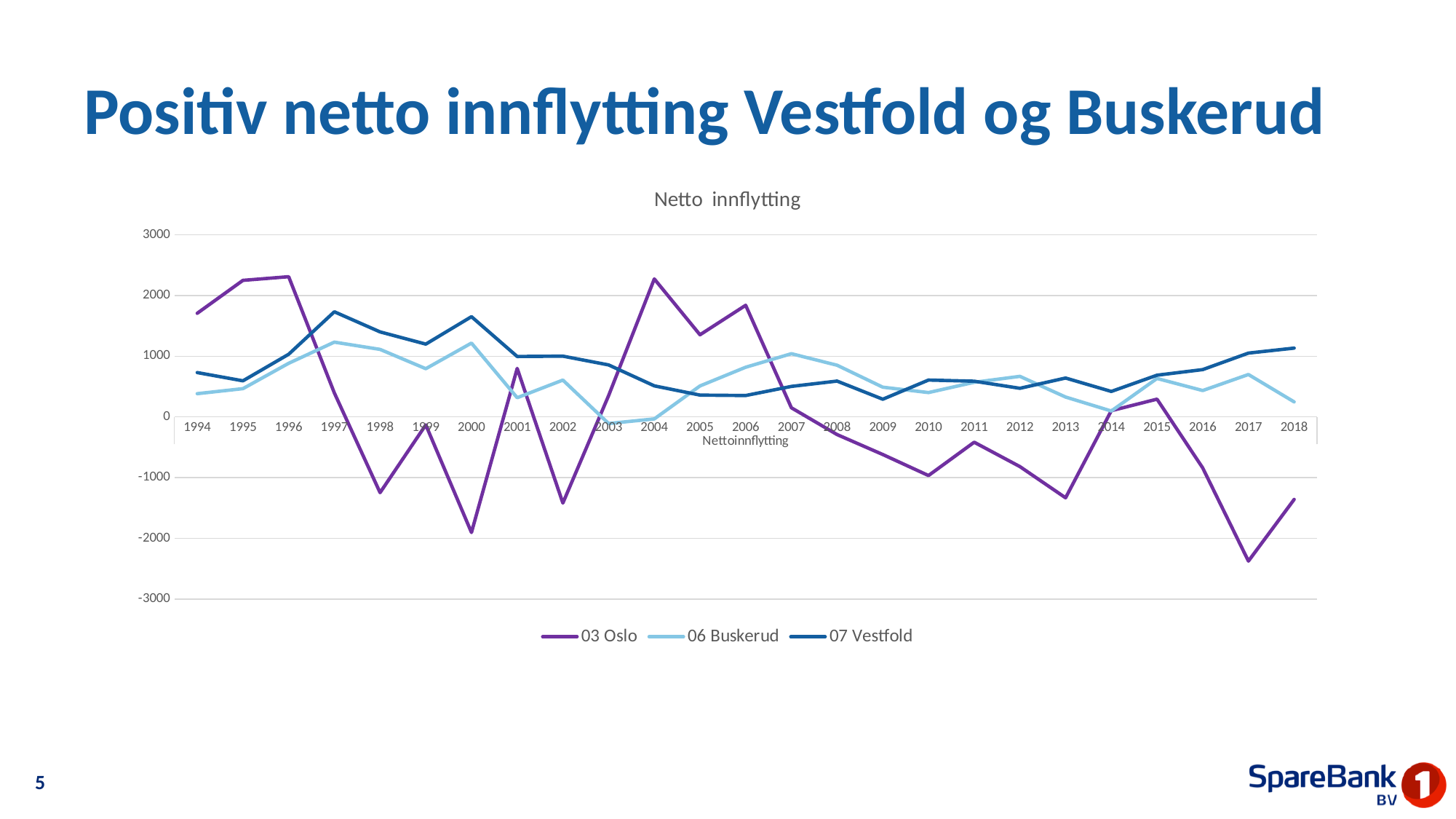
How many series does the legend list? 3 Is the value for 07 Vestfold in 1997 greater or less than 1000? greater How many years are plotted along the x axis? 25 In which year does 03 Oslo reach its lowest value? 2017 What is the title of the chart? Netto innflytting Is the value for 03 Oslo in 2017 greater or less than -2000? less Is the value for 06 Buskerud in 2014 greater or less than 500? less In 2018, which series has the larger value, 07 Vestfold or 06 Buskerud? 07 Vestfold Does the 03 Oslo line rise or fall from 2015 to 2017? fall What kind of chart is shown on the slide? line chart Which series is drawn in purple? 03 Oslo